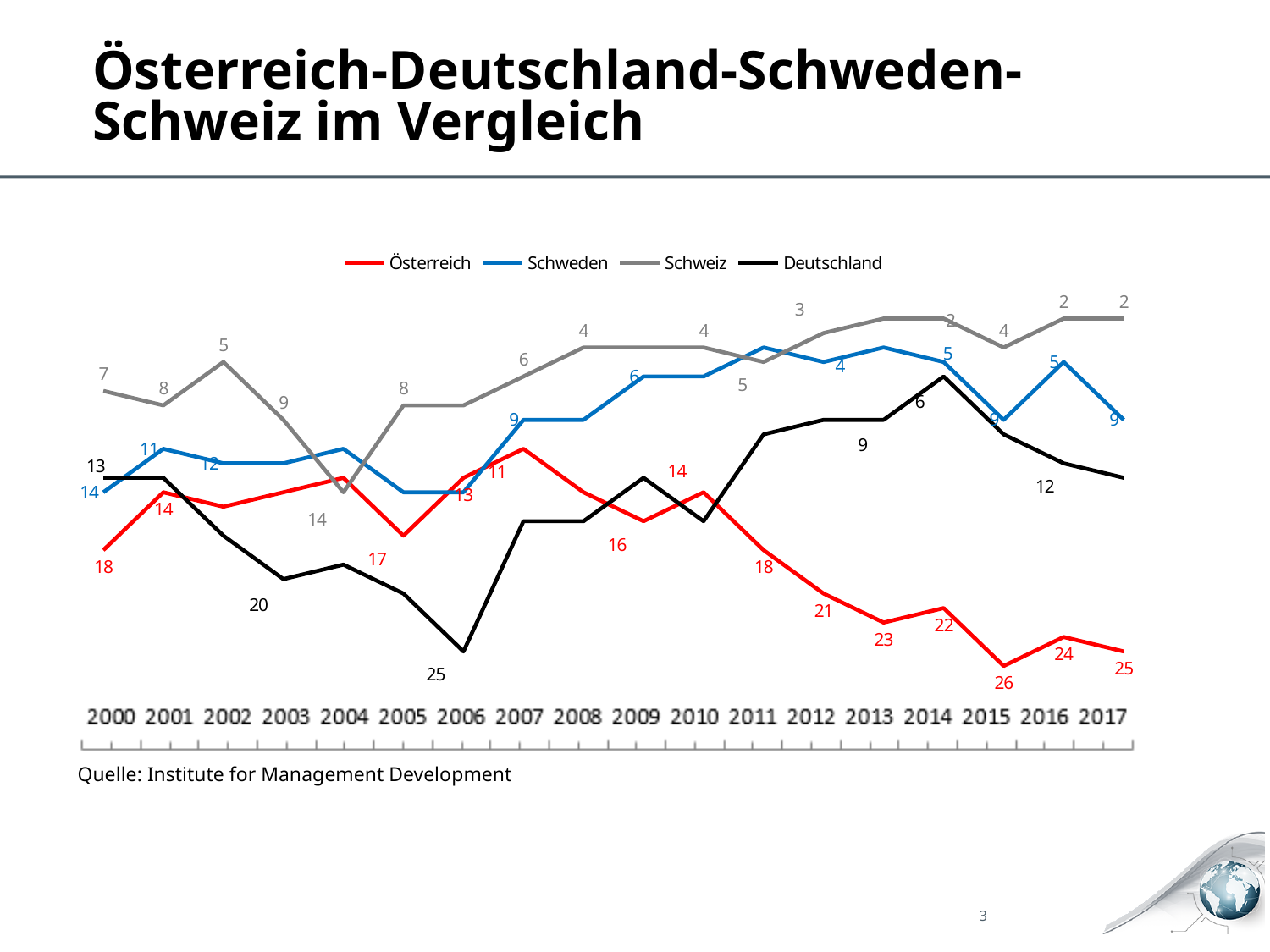
What is the difference between the Österreich values in 2017 and 2000? 7 Do the values for Österreich rise or fall from 2010 to 2013? rise What is the value for Schweden in 2000? 14 How many years are shown on the x axis? 18 In which year does Österreich have its largest value? 2015 What is the value for Deutschland in 2006? 25 What is the value for Österreich in 2017? 25 What kind of chart is shown on the slide? line chart What is the value for Deutschland in 2014? 6 Which is larger: the value for Schweiz in 2004 or the value for Schweden in 2002? Schweiz in 2004 How many series does the legend list? 4 What is the value for Schweiz in 2017? 2